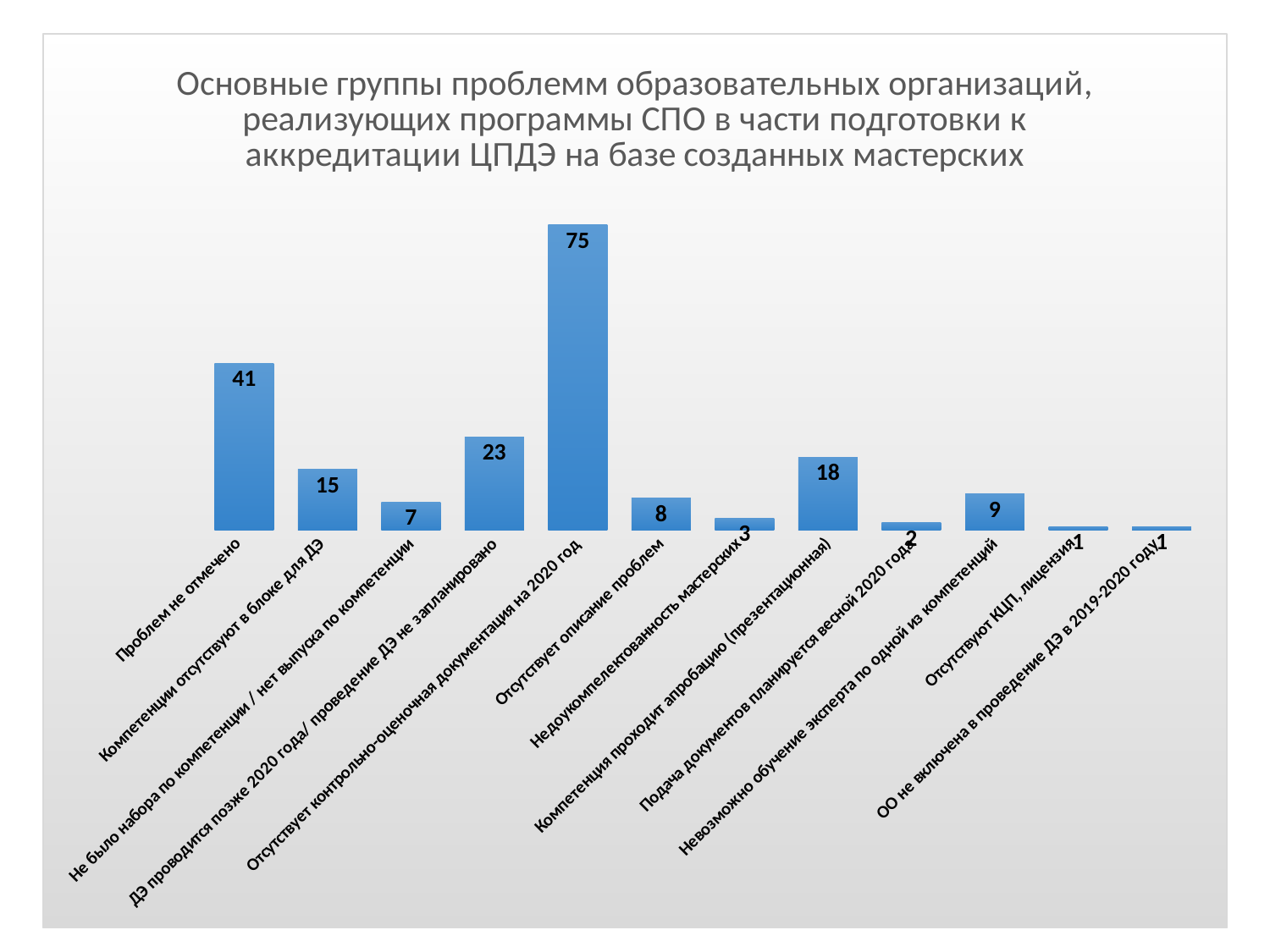
How many categories are plotted in the chart? 12 What is the value for "Недоукомплектованность мастерских"? 3 What is the difference between the values for "Отсутствует контрольно-оценочная документация на 2020 год" and "Проблем не отмечено"? 34 What is the difference between the values for "Невозможно обучение эксперта по одной из компетенций" and "Отсутствует описание проблем"? 1 Which is larger: the value for "ДЭ проводится позже 2020 года/ проведение ДЭ не запланировано" or for "Компетенции отсутствуют в блоке для ДЭ"? ДЭ проводится позже 2020 года/ проведение ДЭ не запланировано What is the value for "Отсутствует контрольно-оценочная документация на 2020 год"? 75 Which category has the highest value? Отсутствует контрольно-оценочная документация на 2020 год What is the value for "Проблем не отмечено"? 41 What is the lowest value shown in the chart? 1 What is the value for "Подача документов планируется весной 2020 года"? 2 What type of chart is shown on the slide? bar chart What is the value for "Компетенция проходит апробацию (презентационная)"? 18